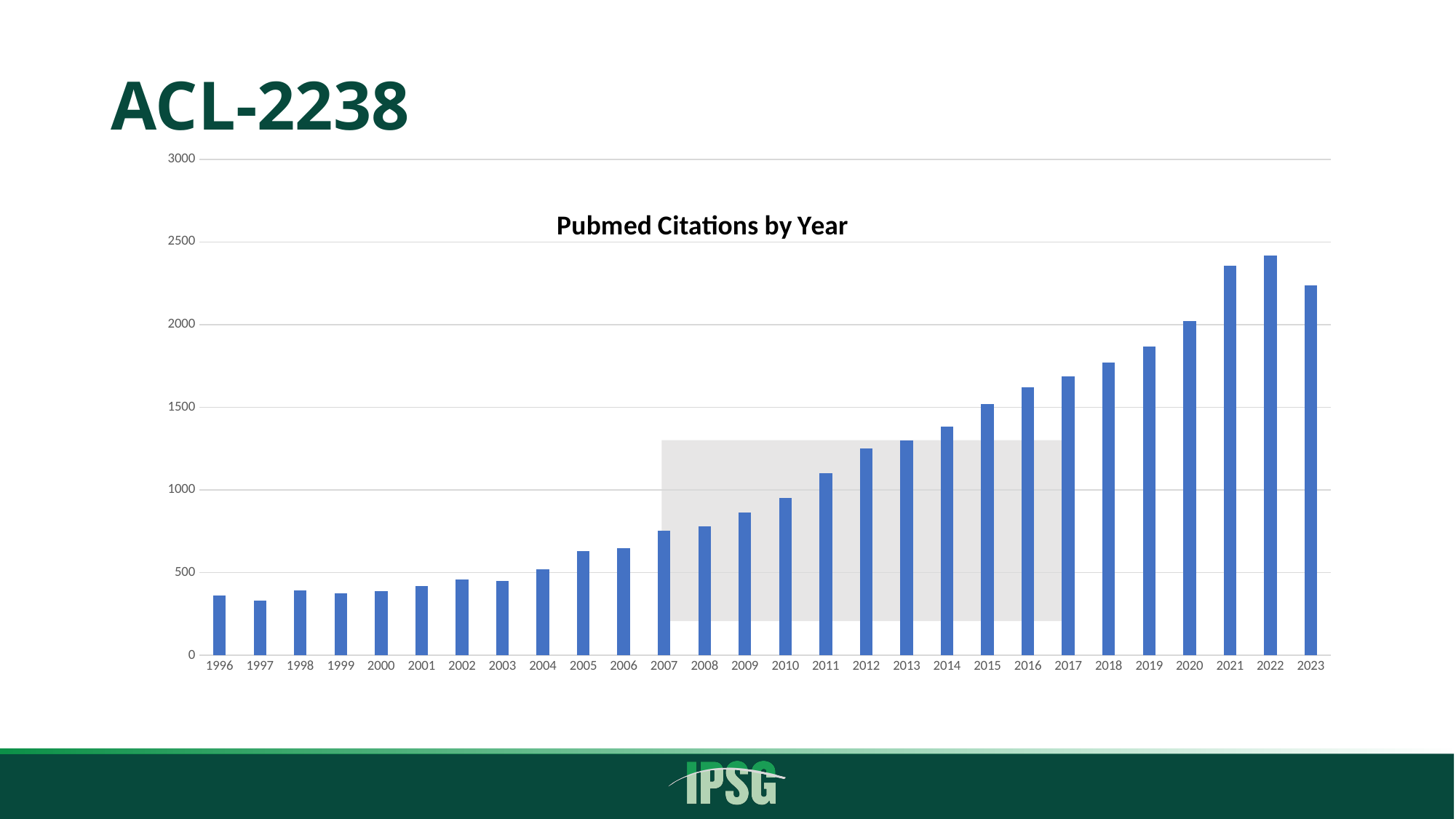
What kind of chart is shown on the slide? Bar chart Is the value for 2023 greater or less than 2000? greater What is the title of the chart? Pubmed Citations by Year What is the highest value shown on the y axis of the chart? 3000 Is the value for 2014 greater or less than 1500? less Is the value for 2011 greater or less than 1000? greater Which year has more Pubmed citations, 2021 or 2023? 2021 How many years are plotted on the x axis of the chart? 28 Which year has the highest number of Pubmed citations? 2022 Do the Pubmed citation counts generally rise or fall from 1996 to 2022? Rise